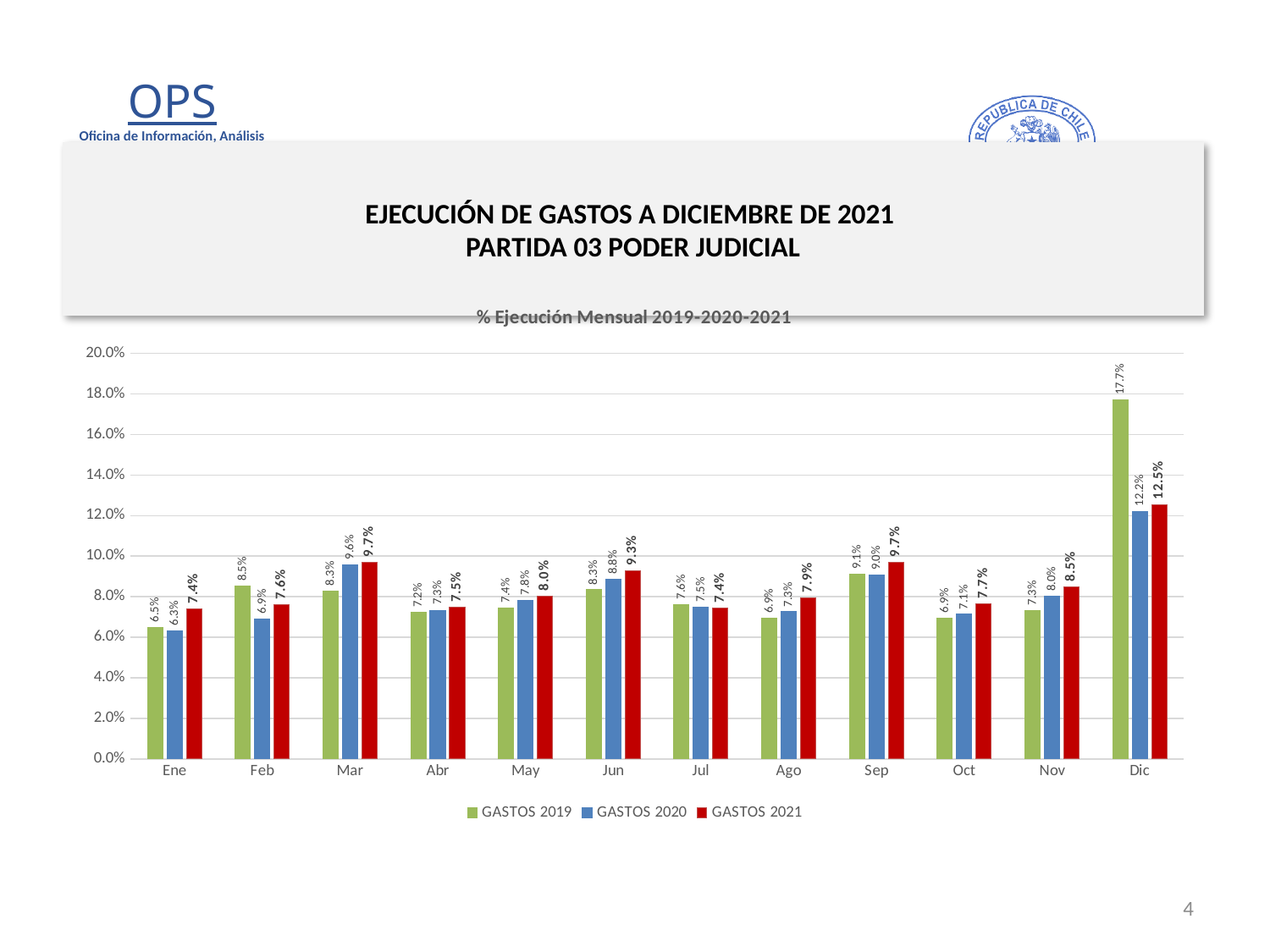
Which is larger in Jul, GASTOS 2019 or GASTOS 2021? GASTOS 2019 How many series does the legend list? 3 What is the value for GASTOS 2019 in Feb? 8.5% What is the value for GASTOS 2020 in Mar? 9.6% What kind of chart is shown on the slide? Bar chart How many months are shown on the x axis? 12 Which month has the highest value for GASTOS 2019? Dic Is the value for GASTOS 2019 in Dic greater or less than 16.0%? greater Which month has the lowest value for GASTOS 2020? Ene What is the value for GASTOS 2021 in Dic? 12.5% What is the difference between GASTOS 2019 and GASTOS 2021 in Dic? 5.2% What is the title of the chart? % Ejecución Mensual 2019-2020-2021